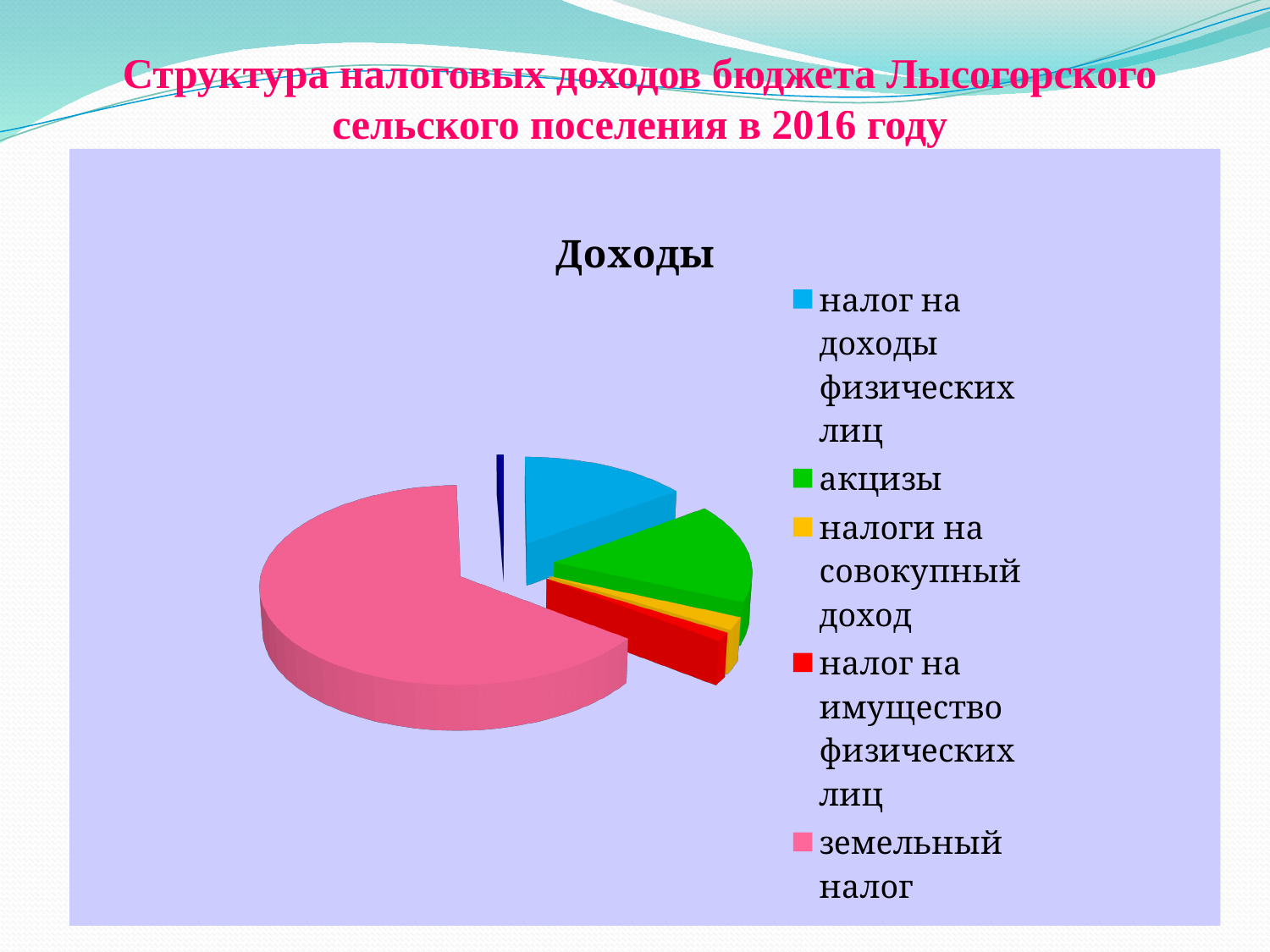
What colour is the slice for земельный налог? pink Is the share of the pie for земельный налог greater or less than 50%? greater What kind of chart is shown on the slide? pie chart How many categories does the chart legend list? 5 Which slice is larger: акцизы or налоги на совокупный доход? акцизы Which slice is larger: налог на доходы физических лиц or налог на имущество физических лиц? налог на доходы физических лиц Which category has the largest slice of the pie? земельный налог What is the title of the chart? Доходы Which slice is larger: земельный налог or акцизы? земельный налог